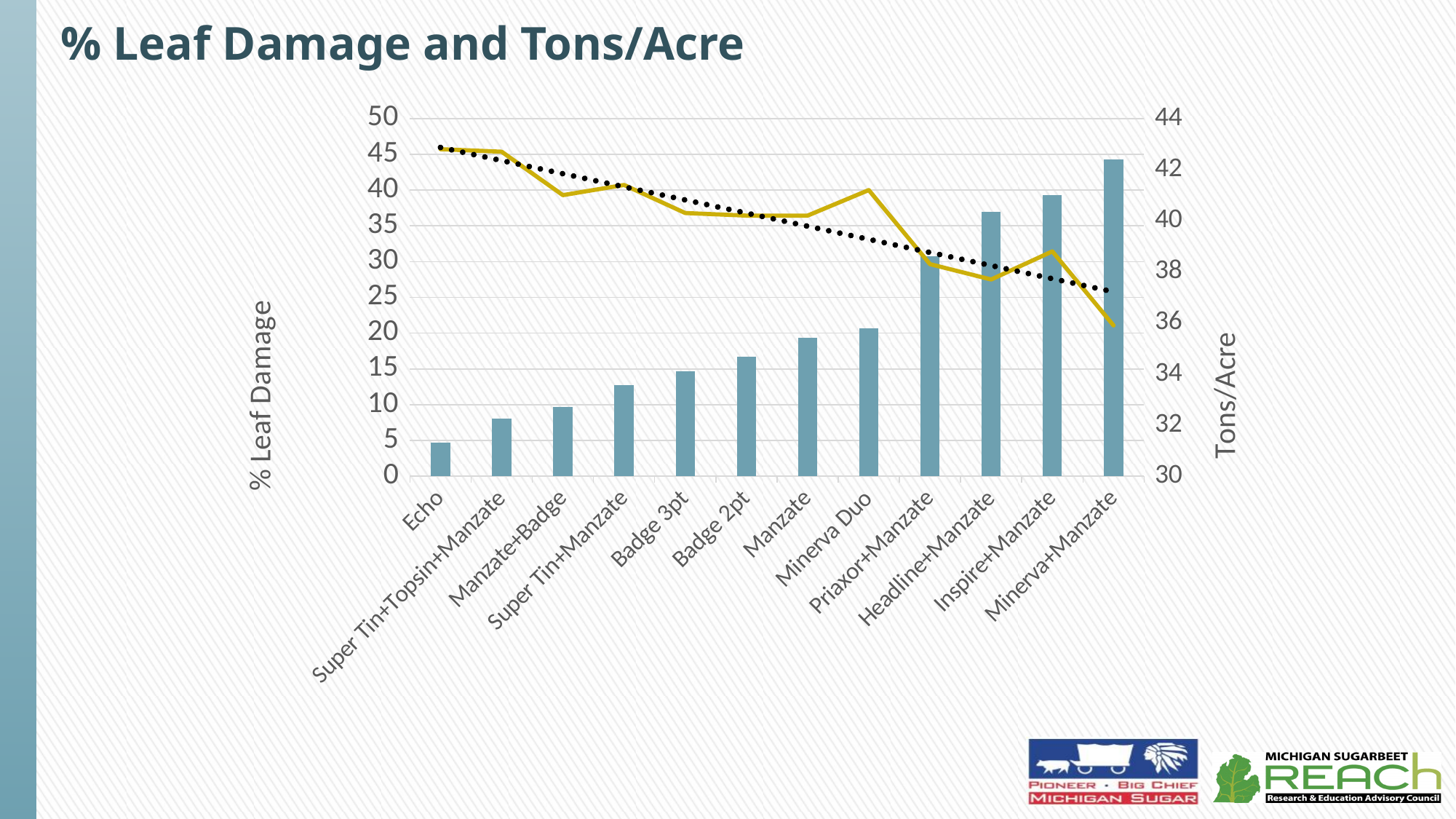
Which treatment has the lowest % Leaf Damage bar? Echo Do the % Leaf Damage bars rise or fall from left to right across the x axis? rise What is the title of the chart on the slide? % Leaf Damage and Tons/Acre Does the Tons/Acre line generally rise or fall from Echo to Minerva+Manzate? fall Which has a taller % Leaf Damage bar, Headline+Manzate or Badge 2pt? Headline+Manzate Is the % Leaf Damage bar for Echo greater or less than 10? less Is the % Leaf Damage bar for Minerva+Manzate greater or less than 40? greater What is the label on the right-hand vertical axis of the chart? Tons/Acre What kind of chart is shown on the slide? Combination bar and line chart How many treatment categories are shown on the x axis of the chart? 12 Is the % Leaf Damage bar for Manzate greater or less than 15? greater Which treatment has the highest % Leaf Damage bar? Minerva+Manzate